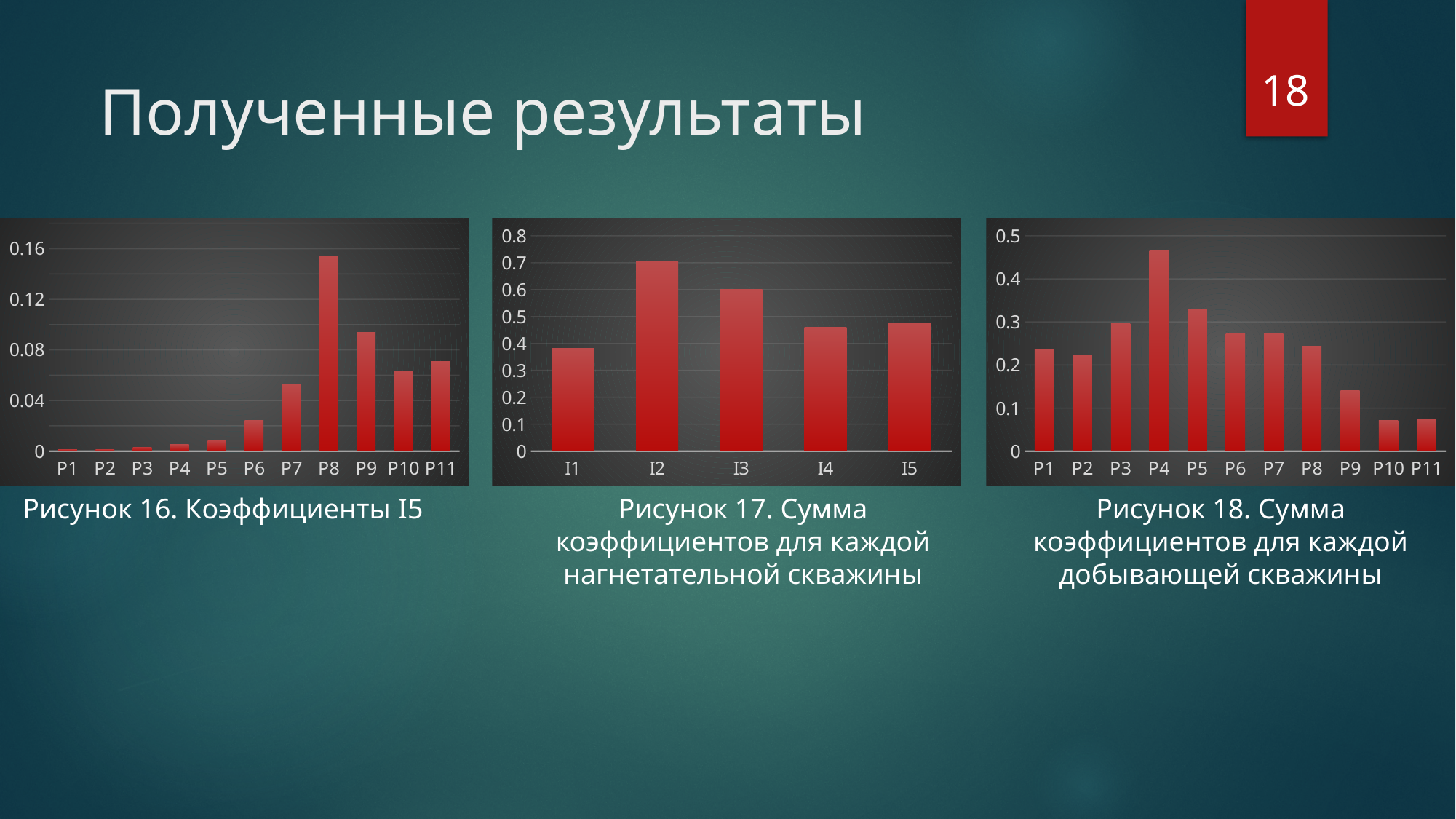
In the chart titled "Рисунок 17" (middle chart), how many categories are shown? 5 In the chart titled "Рисунок 16. Коэффициенты I5", how many categories are shown on the x axis? 11 In the chart titled "Рисунок 17" (middle chart), which is larger, the value for I3 or the value for I4? I3 In the chart titled "Рисунок 17" (middle chart), which category has the highest value? I2 In the chart titled "Рисунок 16. Коэффициенты I5", is the value for P6 greater or less than 0.04? less In the chart titled "Рисунок 17" (middle chart), is the value for I3 greater or less than 0.5? greater In the chart titled "Рисунок 17" (middle chart), which category has the lowest value? I1 In the chart titled "Рисунок 16. Коэффициенты I5", which category has the highest value? P8 In the chart titled "Рисунок 18" (right chart), which category has the highest value? P4 In the chart titled "Рисунок 18" (right chart), is the value for P10 greater or less than 0.1? less What type of chart is the chart titled "Рисунок 18" (right chart)? Bar chart